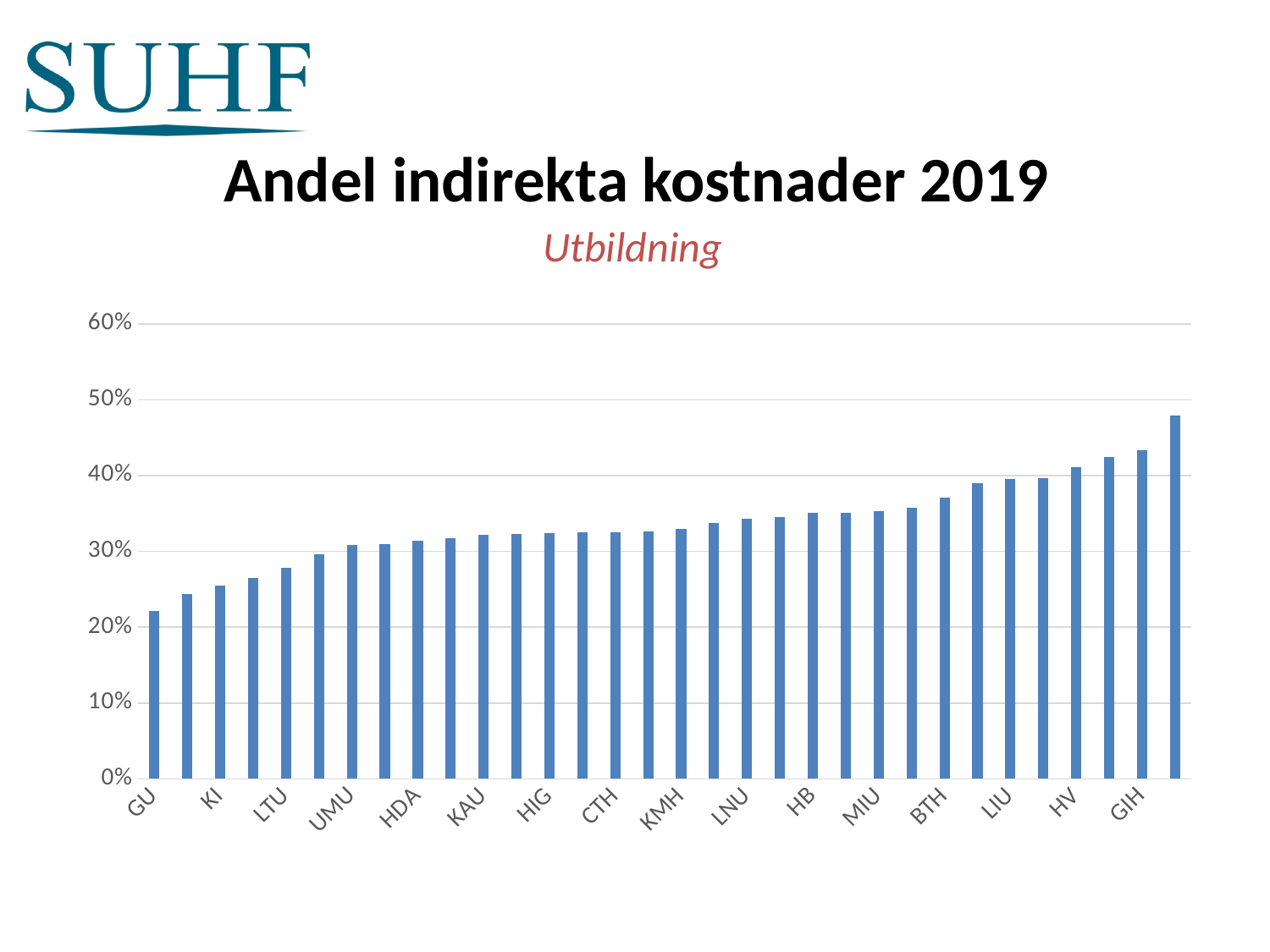
Is the value for LTU greater or less than 30%? less Which has the larger value, GIH or GU? GIH What subtitle appears below the chart title? Utbildning Is the value for GIH greater or less than 40%? greater What kind of chart is shown on the slide? bar chart Do the values rise or fall from left to right along the x axis? rise Is the value for BTH greater or less than 40%? less What is the title of the chart? Andel indirekta kostnader 2019 Which has the larger value, KI or HV? HV Which labeled category has the lowest value? GU